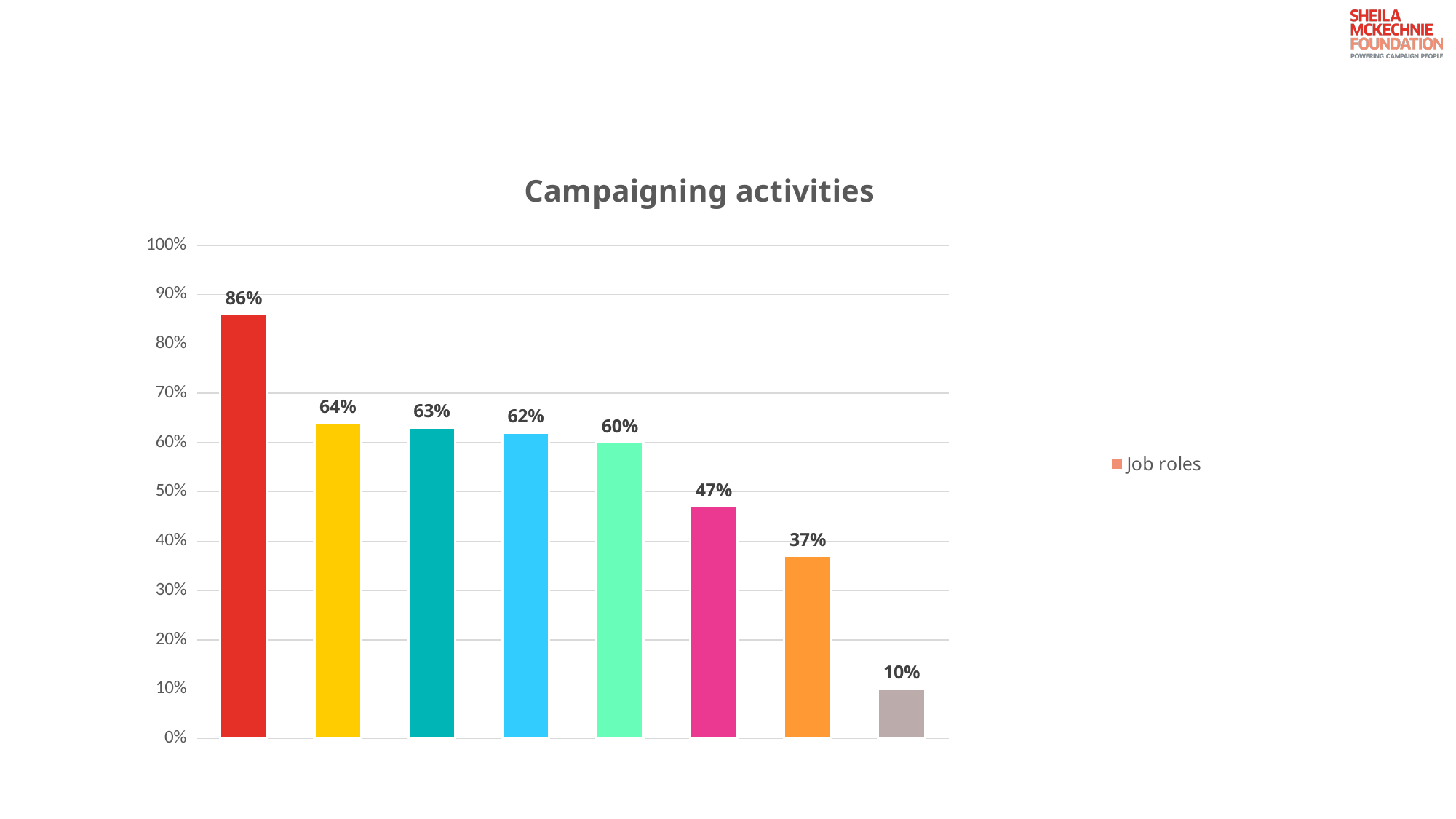
Do the bar values rise or fall from left to right across the chart? fall How many series does the legend list? 1 What kind of chart is shown on the slide? bar chart What is the title of the chart? Campaigning activities What is the highest value shown in the chart? 86% Which is larger, the yellow bar or the orange bar? the yellow bar How many bars are plotted in the chart? 8 What is the lowest value shown in the chart? 10% What is the value of the pink bar (the sixth bar from the left)? 47% What is the value of the red bar (the first bar from the left)? 86% What is the difference between the first bar (86%) and the last bar (10%)? 76% What is the name of the series shown in the legend? Job roles